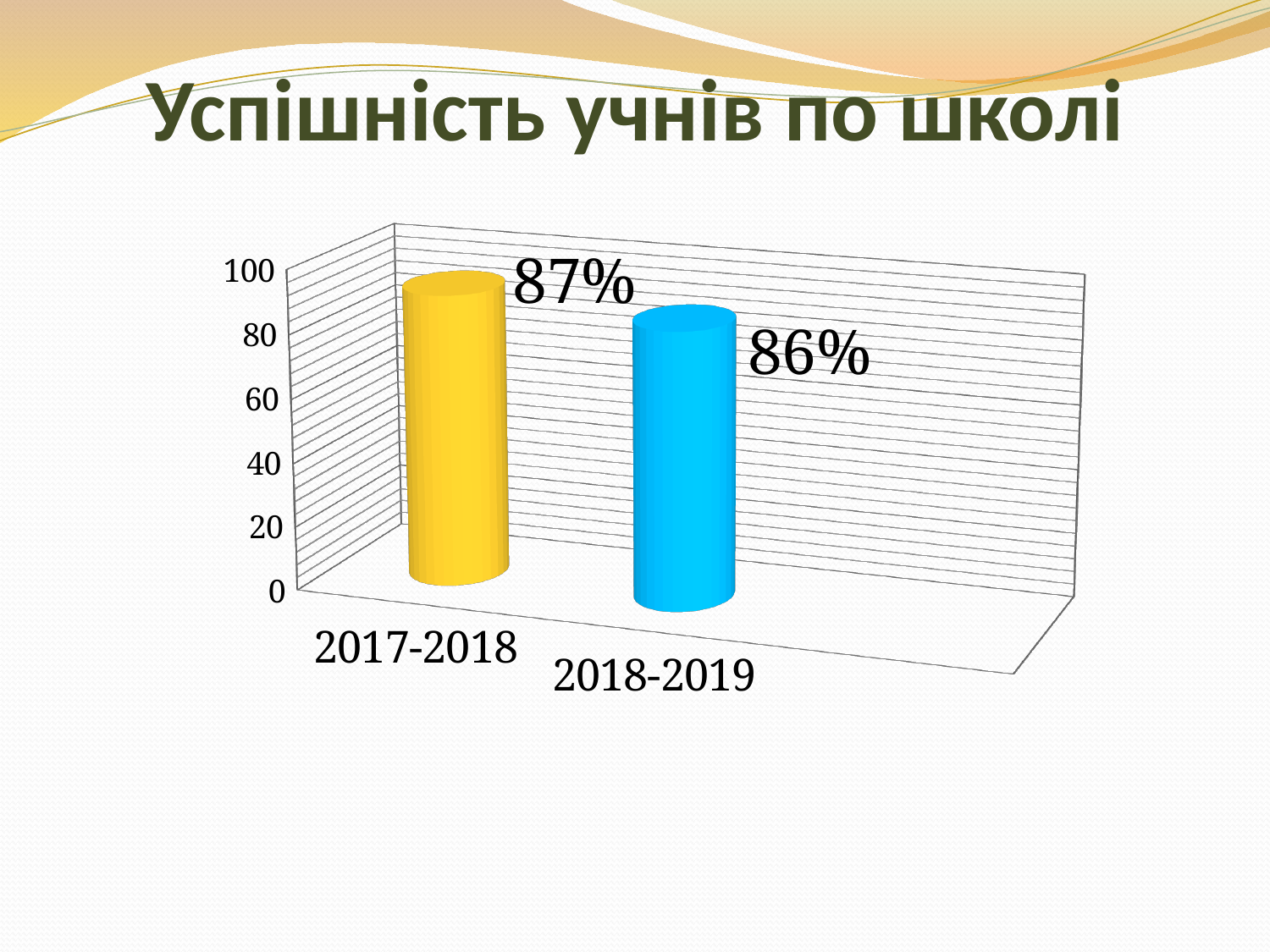
What is the difference between the values for 2017-2018 and 2018-2019? 1% What is the value for 2017-2018? 87% Which year has the highest value? 2017-2018 Which year has the lowest value? 2018-2019 Which is larger, the value for 2017-2018 or for 2018-2019? 2017-2018 Do the values rise or fall from 2017-2018 to 2018-2019? fall Is the value for 2018-2019 greater or less than 80? greater What is the value for 2018-2019? 86% What kind of chart is shown on the slide? bar chart What is the title of the slide? Успішність учнів по школі What colour is the bar for 2018-2019? blue How many categories are shown on the chart? 2